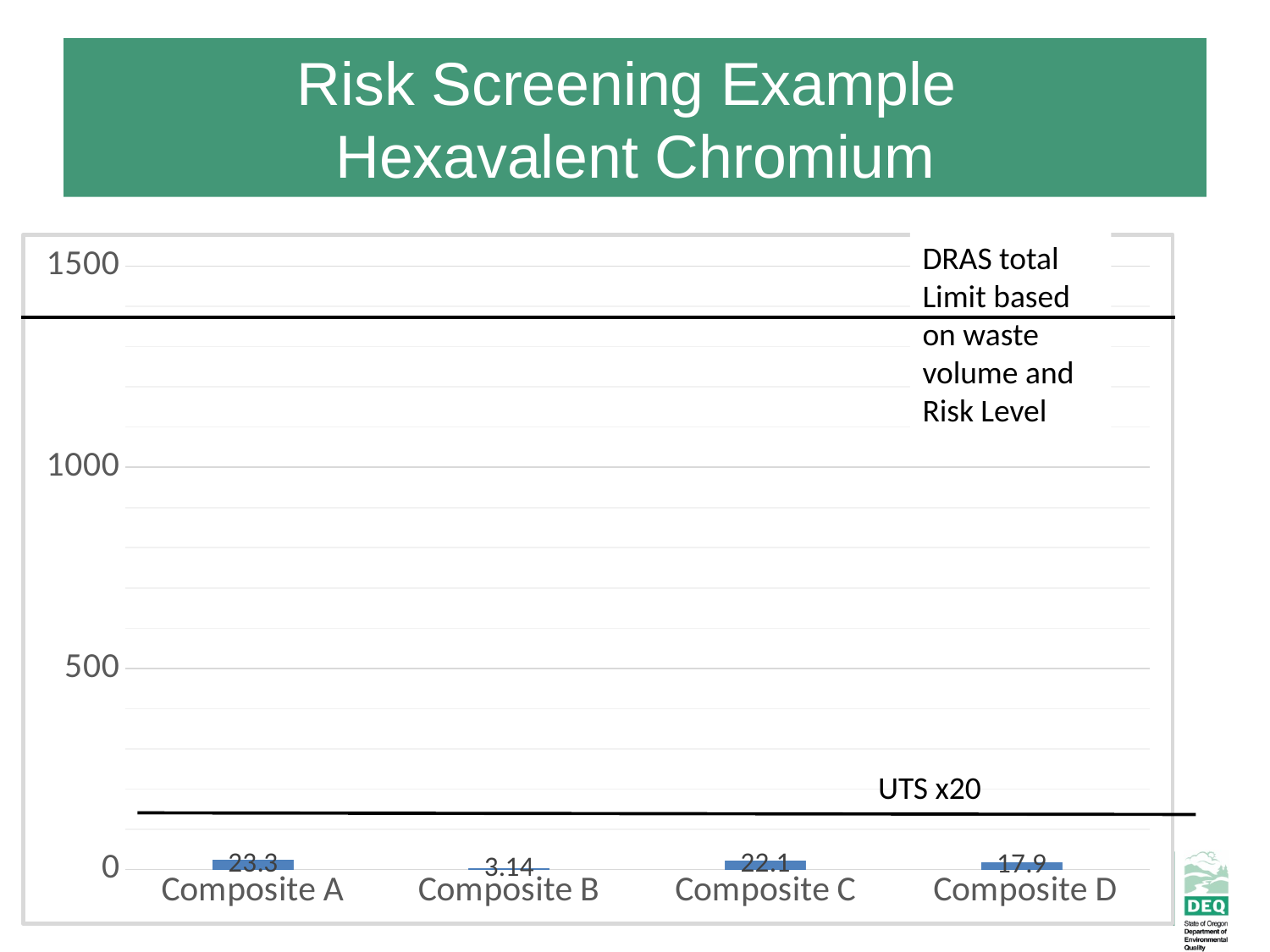
What is the label of the lower horizontal reference line on the chart? UTS x20 Which composite has the lowest value? Composite B What is the value for Composite C? 22.1 Which composite has the highest value? Composite A What is the difference between the values for Composite A and Composite B? 20.16 What is the value for Composite B? 3.14 Which is larger, the value for Composite C or the value for Composite D? Composite C What is the value for Composite A? 23.3 Is the value for Composite A greater or less than 500? less What kind of chart is shown on the slide? bar chart What is the value for Composite D? 17.9 How many composites are plotted on the chart? 4